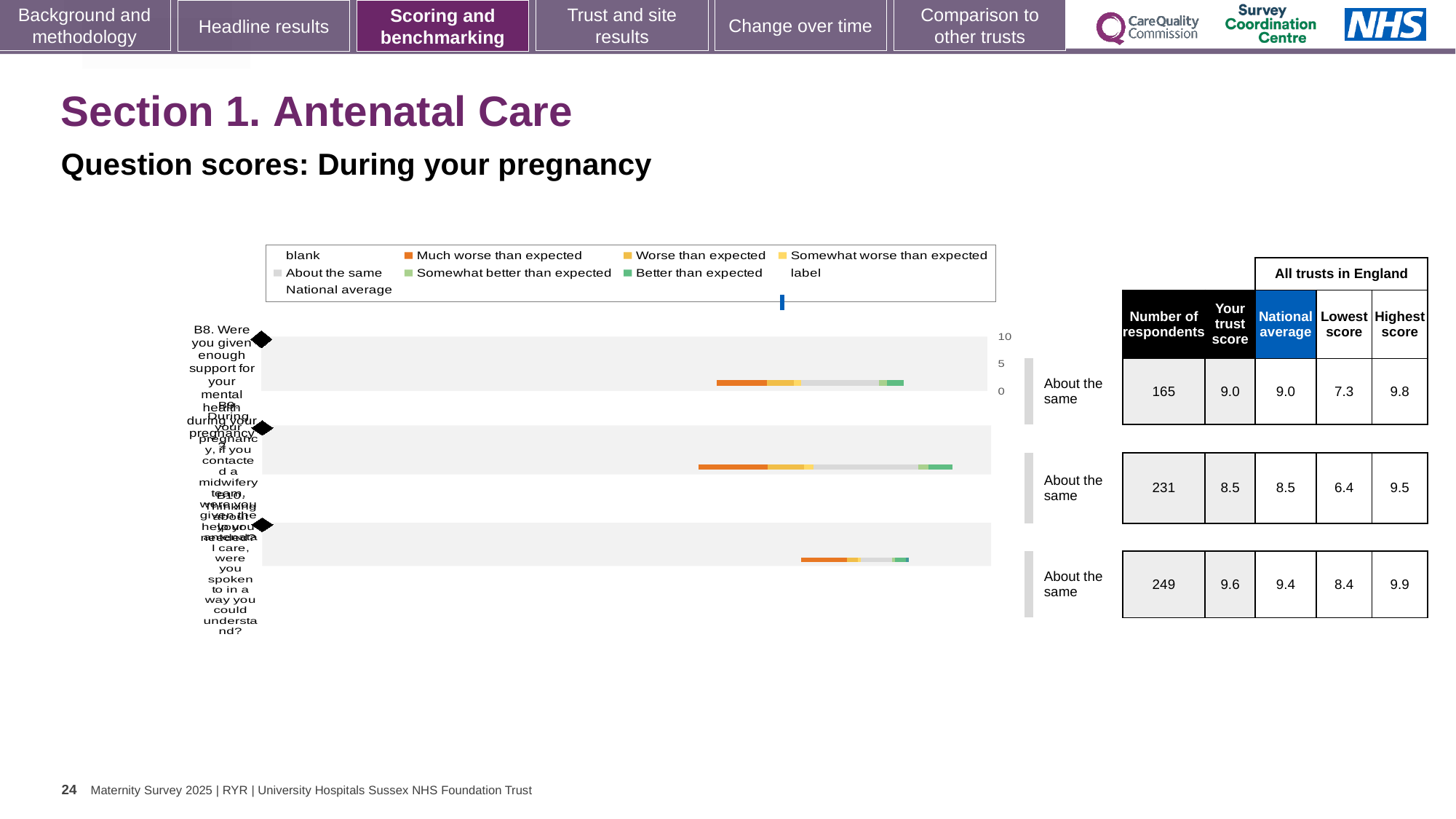
In the table beside the chart, is the trust score for the third row larger or smaller than its national average? larger What is the benchmark rating shown next to the first bar (B8, support for your mental health during pregnancy)? About the same In the table beside the chart, what is the national average for the third row? 9.4 What is the highest value shown on the chart's numeric axis? 10 What kind of chart is shown on the slide? bar chart In the table beside the chart, which row has the highest number of respondents? the third row (249) In the table beside the chart, what is the difference between the highest score and the lowest score for the first row (B8)? 2.5 In the table beside the chart, what is the number of respondents for the first row (B8)? 165 In the table beside the chart, what is the lowest score for the second row? 6.4 In the table beside the chart, which row has the lowest trust score? the second row (8.5) How many question rows (bars) are plotted in the chart? 3 In the table beside the chart, what is the trust score for the first row (B8)? 9.0